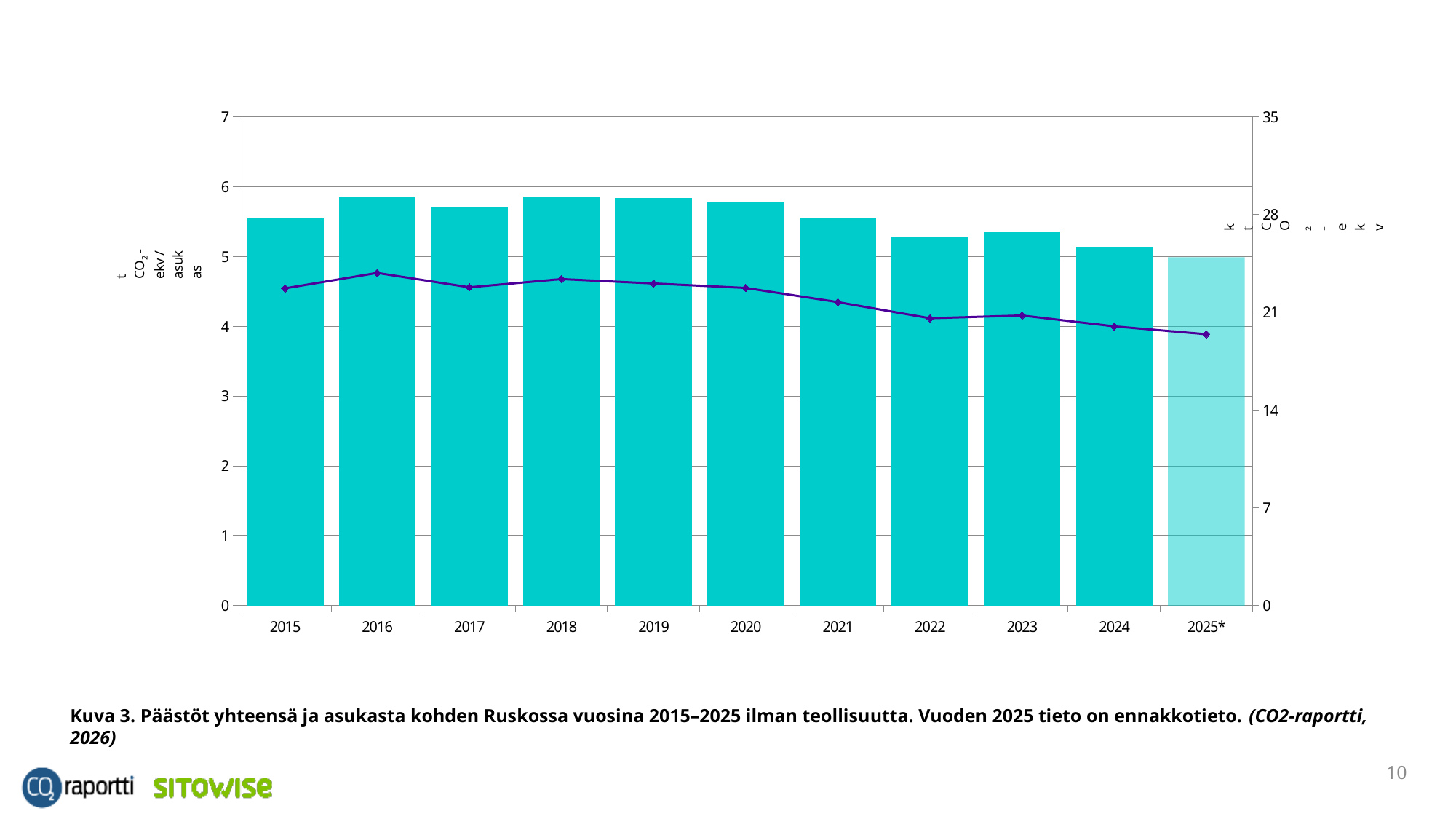
Is the purple line value for 2016 greater or less than 21 on the right axis? greater Is the bar for 2016 greater or less than 6 on the left axis? less What is the highest value shown on the right-hand axis of the chart? 35 Which year has the lowest point on the purple line? 2025* Is the bar for 2015 greater or less than 5 on the left axis? greater Which bar is taller, 2016 or 2024? 2016 What kind of chart is shown on the slide? A bar chart combined with a line Do the values of the purple line generally rise or fall from 2016 to 2025*? fall Which year has the lowest bar in the chart? 2025* How many years are shown on the x axis of the chart? 11